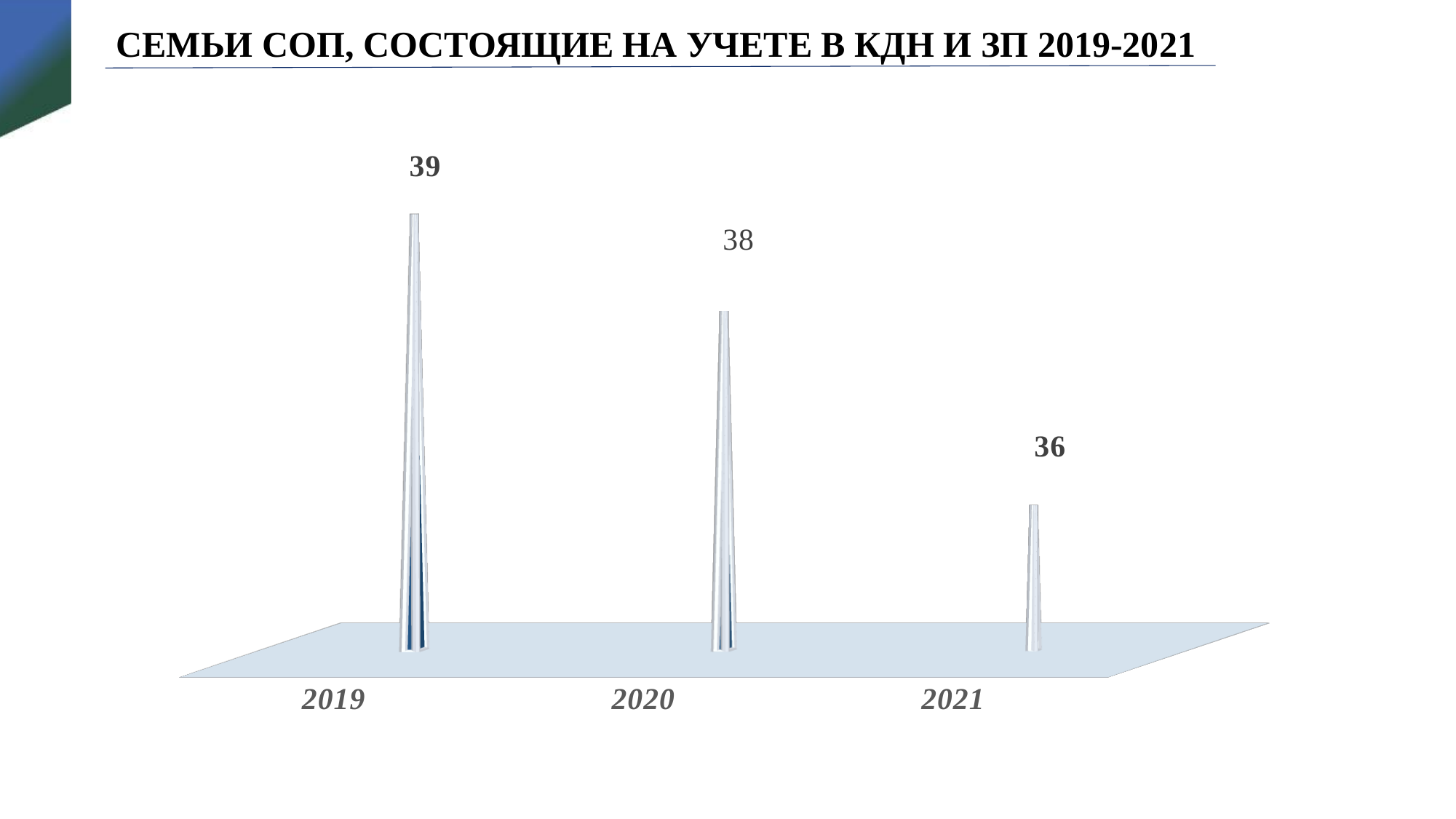
Do the values rise or fall from 2019 to 2021? fall Which year has the highest value? 2019 What is the difference between the values for 2020 and 2021? 2 What kind of chart is shown on the slide? bar chart What is the difference between the values for 2019 and 2021? 3 What is the title of the chart? СЕМЬИ СОП, СОСТОЯЩИЕ НА УЧЕТЕ В КДН И ЗП 2019-2021 What is the value for 2021? 36 What is the value for 2020? 38 Which is larger, the value for 2019 or the value for 2020? 2019 How many years are shown on the chart? 3 What is the value for 2019? 39 Which year has the lowest value? 2021